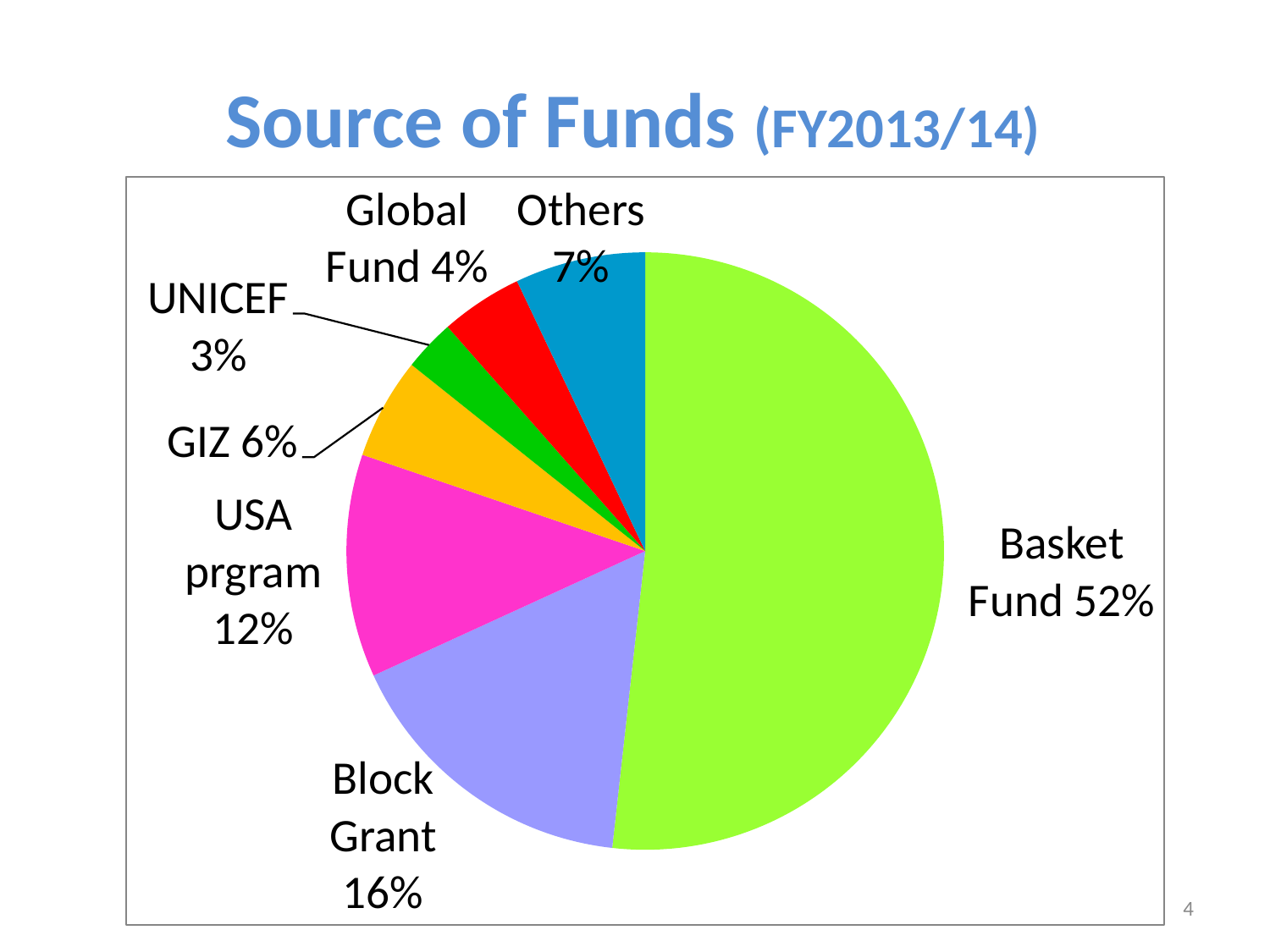
What share of funds comes from the USA prgram? 12% How many slices does the pie chart have? 7 What share of funds comes from the Block Grant? 16% What is the difference in percentage points between the Block Grant and the USA prgram shares? 4 What share of funds comes from the Global Fund? 4% What share of funds comes from the Basket Fund? 52% What share of funds comes from GIZ? 6% What share of funds comes from UNICEF? 3% What type of chart is shown on the slide? pie chart Which source of funds has the smallest share? UNICEF Which is larger, the share for Others or the share for GIZ? Others Which source of funds has the largest share? Basket Fund